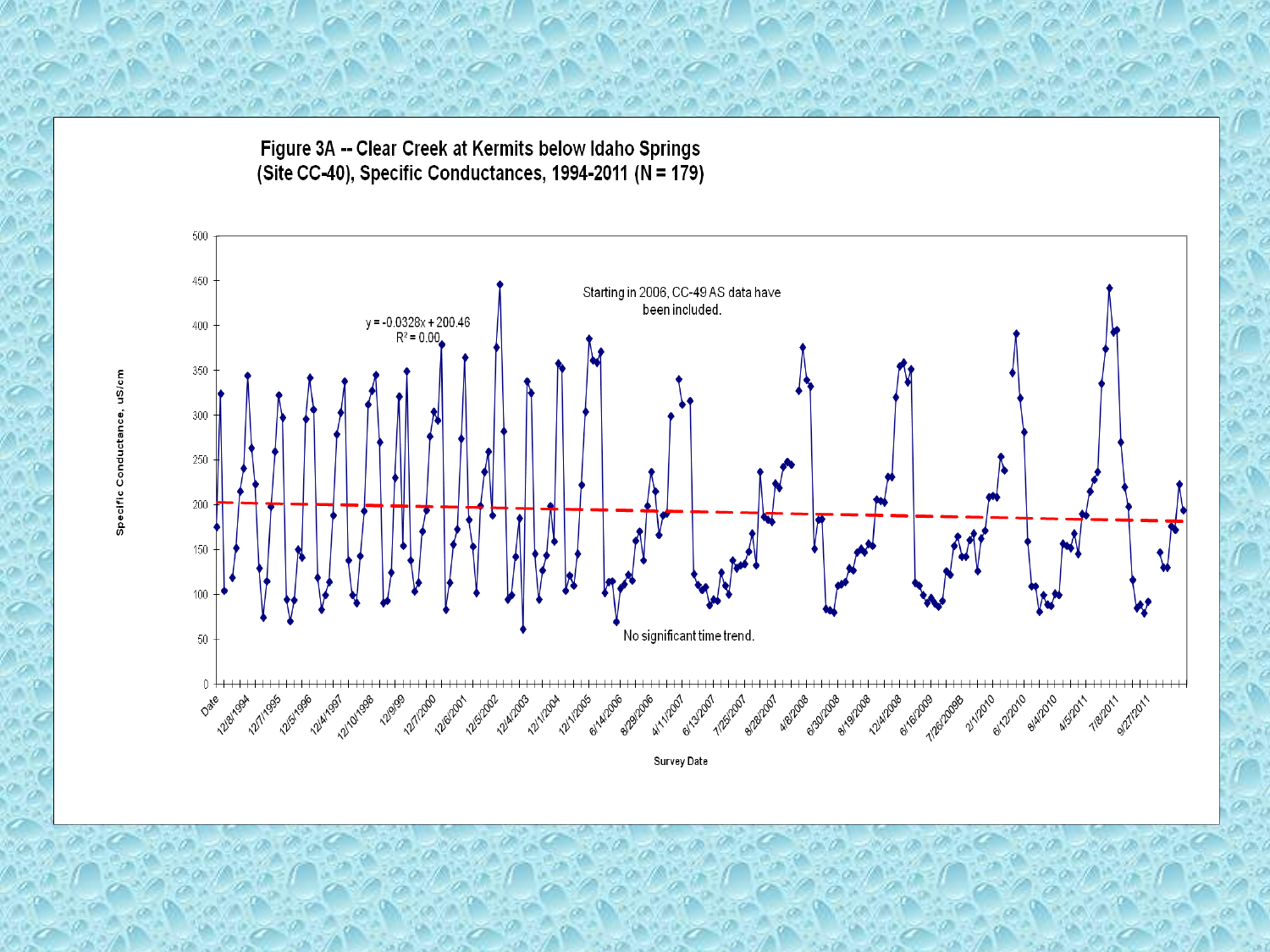
Is the lowest plotted specific conductance value greater or less than 100? less What R² value is printed on the chart for the trend line? R² = 0.00 Is the highest plotted specific conductance value greater or less than 400? greater Does the dashed red trend line rise or fall from left to right across the chart? Falls slightly What is the maximum value shown on the vertical axis? 500 According to the annotation on the chart, is there a significant time trend in specific conductance? No What trend-line equation is printed on the chart? y = -0.0328x + 200.46 What is the label of the vertical axis? Specific Conductance, uS/cm What kind of chart is shown on the slide? Line chart What is the title of the chart? Figure 3A -- Clear Creek at Kermits below Idaho Springs (Site CC-40), Specific Conductances, 1994-2011 (N = 179) Starting in which year does the chart note that CC-49 AS data have been included? 2006 How many data points (N) does the chart title say are plotted? 179